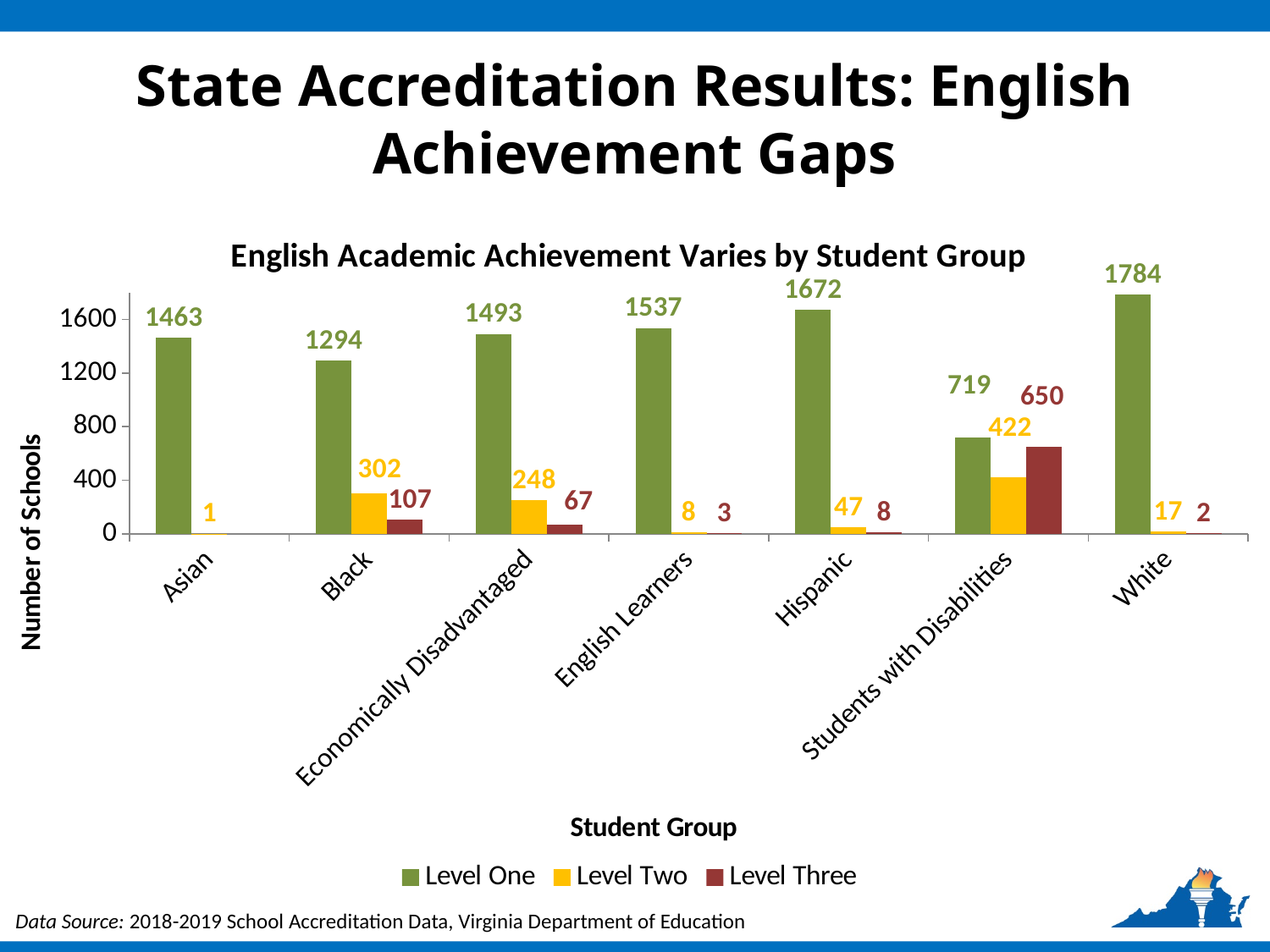
What is the Level One value for Hispanic? 1672 Which student group has the highest Level One value? White How many series does the legend list? 3 What kind of chart is shown on the slide? bar chart What is the Level Two value for Black? 302 What is the title of the chart? English Academic Achievement Varies by Student Group Which student group has the lowest Level One value? Students with Disabilities How many student groups are shown on the x axis? 7 What is the Level Three value for Students with Disabilities? 650 What is the difference between the Level One values for White and Asian? 321 Which is larger for Students with Disabilities, the Level Two value or the Level Three value? Level Three Is the Level One value for Economically Disadvantaged greater or less than 1200? greater